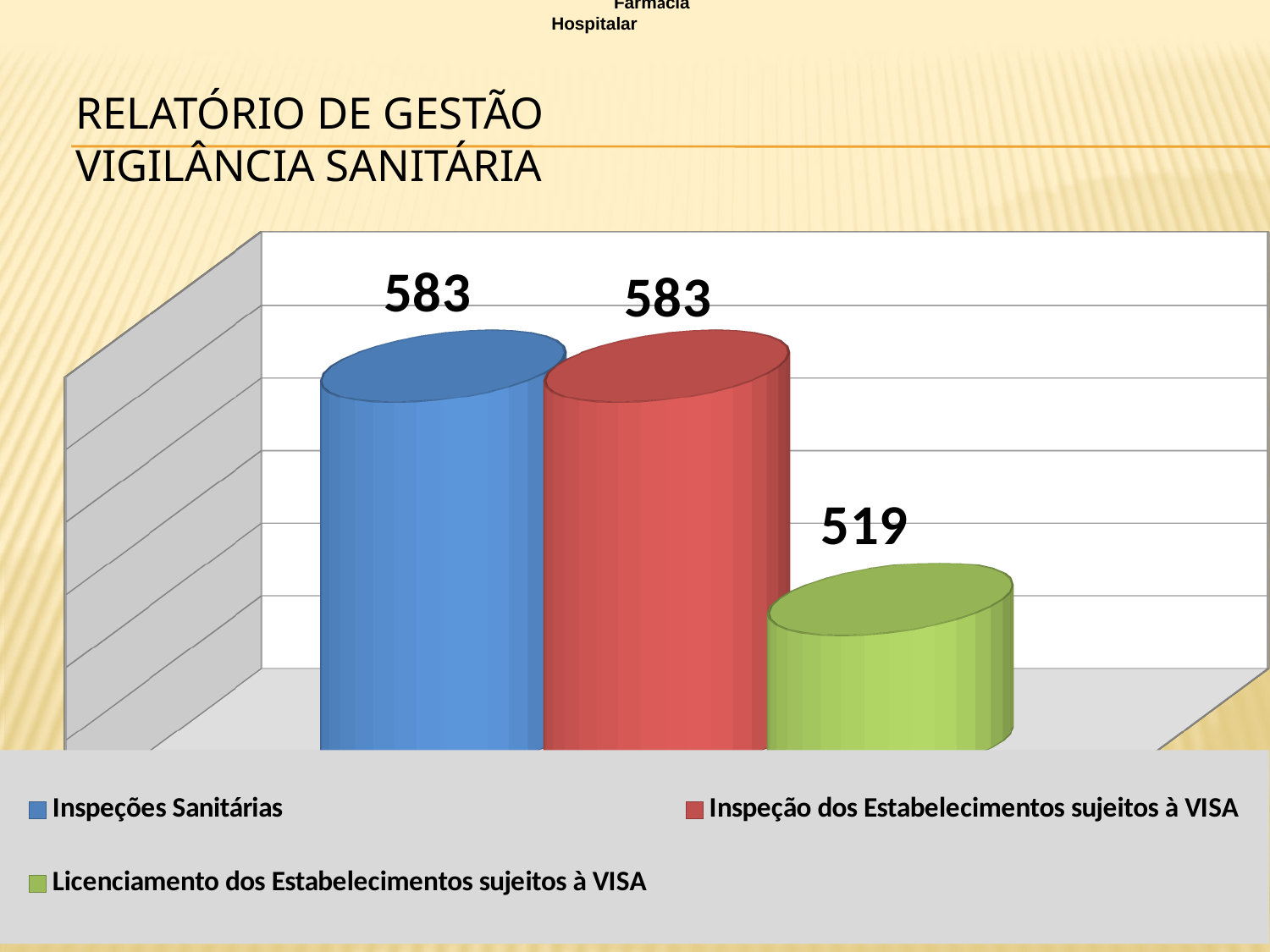
What kind of chart is shown on the slide? Bar chart Which is larger: the value for Inspeção dos Estabelecimentos sujeitos à VISA or the value for Licenciamento dos Estabelecimentos sujeitos à VISA? Inspeção dos Estabelecimentos sujeitos à VISA What is the value for Licenciamento dos Estabelecimentos sujeitos à VISA? 519 How many series does the legend list? 3 What is the highest value shown on the chart? 583 What is the value for Inspeções Sanitárias? 583 How many bars are plotted on the chart? 3 What is the value for Inspeção dos Estabelecimentos sujeitos à VISA? 583 Which series is shown in blue in the legend? Inspeções Sanitárias Which series has the lowest value? Licenciamento dos Estabelecimentos sujeitos à VISA What is the difference between the value for Inspeções Sanitárias and the value for Licenciamento dos Estabelecimentos sujeitos à VISA? 64 What colour is the bar for Licenciamento dos Estabelecimentos sujeitos à VISA? Green